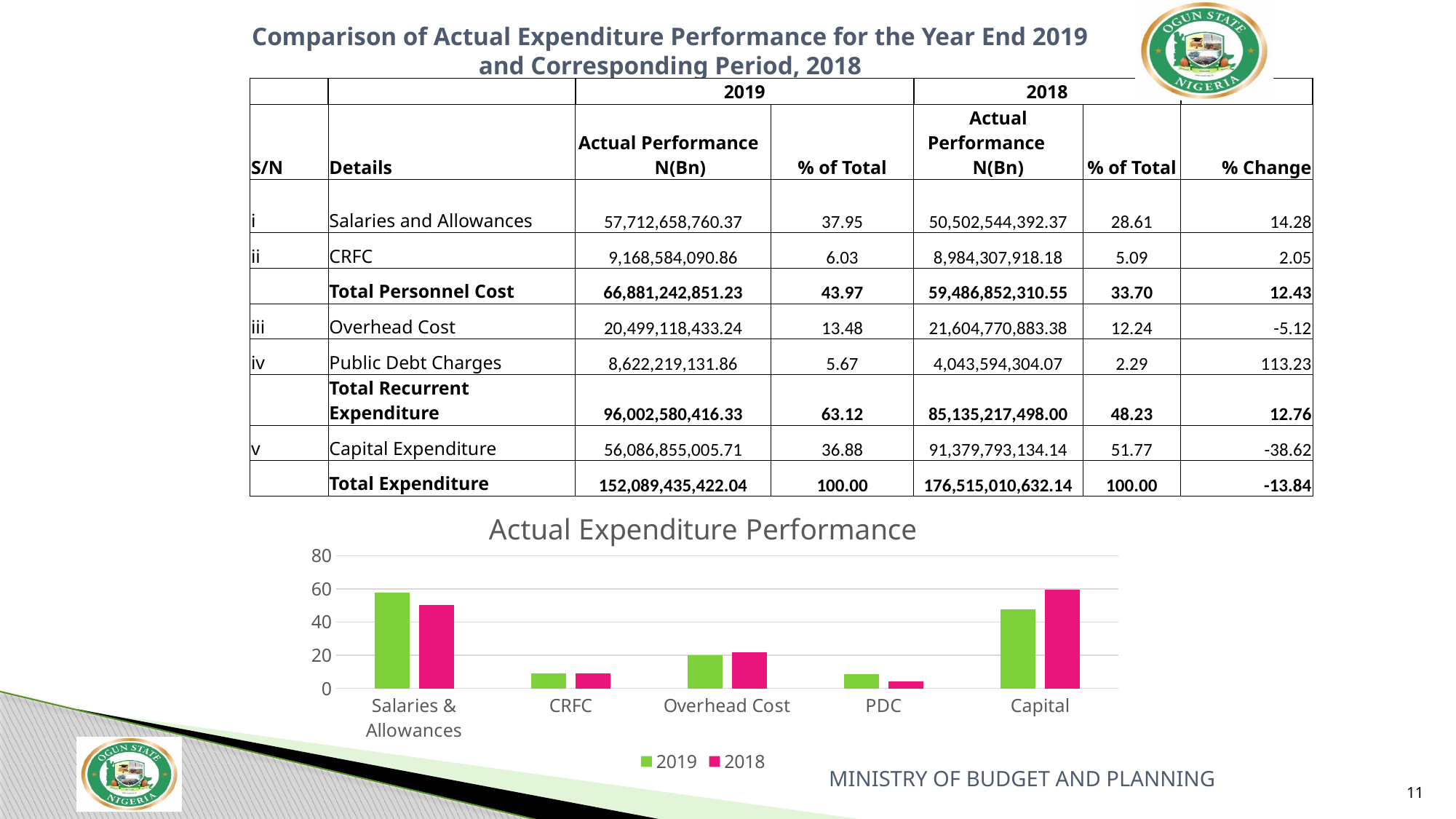
How many categories are shown on the x axis of the chart? 5 What is the title of the chart? Actual Expenditure Performance What kind of chart is shown on the slide? bar chart How many series does the chart's legend list? 2 Which category has the highest 2018 bar in the chart? Capital For Capital, is the 2019 bar or the 2018 bar larger? 2018 Which category has the lowest 2018 bar in the chart? PDC Is the 2019 value for Salaries & Allowances greater or less than 40? greater Is the 2019 value for PDC greater or less than 20? less Which colour represents the 2019 series in the chart? green Which category has the highest 2019 bar in the chart? Salaries & Allowances For Salaries & Allowances, is the 2019 bar or the 2018 bar larger? 2019